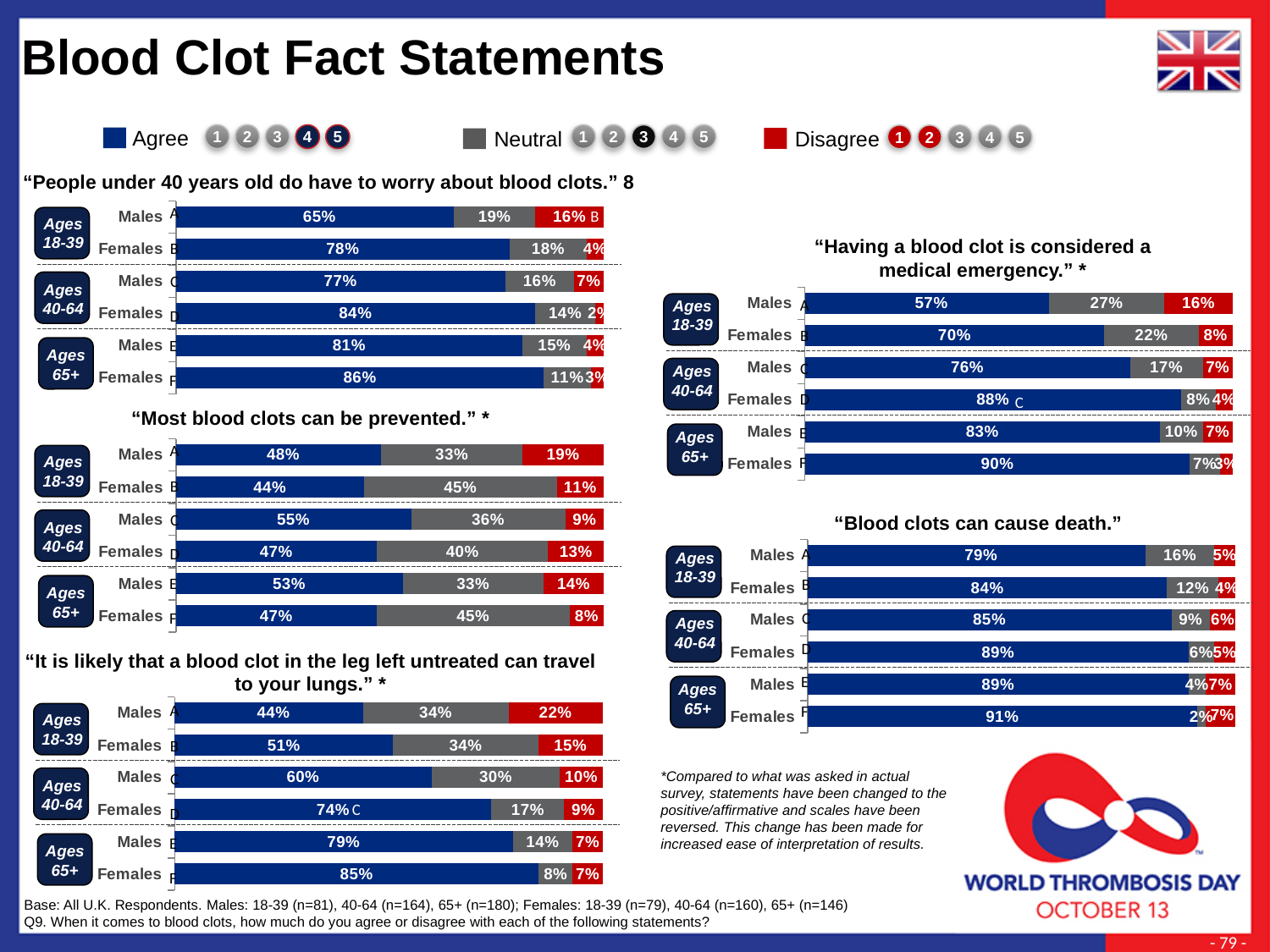
In the chart "It is likely that a blood clot in the leg left untreated can travel to your lungs.", what is the difference between the Agree percentages of Females 65+ and Males 18-39? 41% In the chart "Having a blood clot is considered a medical emergency.", which group has the lowest Agree percentage? Males 18-39 How many groups (bars) are shown in the chart "Most blood clots can be prevented."? 6 In the chart "It is likely that a blood clot in the leg left untreated can travel to your lungs.", what is the Disagree percentage for Males aged 18-39? 22% How many response categories does the legend at the top of the slide list? 3 In the chart "People under 40 years old do have to worry about blood clots.", which group has the highest Agree percentage? Females 65+ In the chart "Blood clots can cause death.", what is the Agree percentage for Females aged 65+? 91% In the chart "Blood clots can cause death.", which is larger: the Agree percentage for Males 18-39 or for Males 40-64? Males 40-64 In the chart "People under 40 years old do have to worry about blood clots.", what percentage of Males aged 18-39 agree? 65% In the chart "Most blood clots can be prevented.", what is the Neutral percentage for Females aged 18-39? 45% In the chart "Having a blood clot is considered a medical emergency.", what percentage of Females aged 40-64 agree? 88% In the chart "Most blood clots can be prevented.", which group has the highest Disagree percentage? Males 18-39